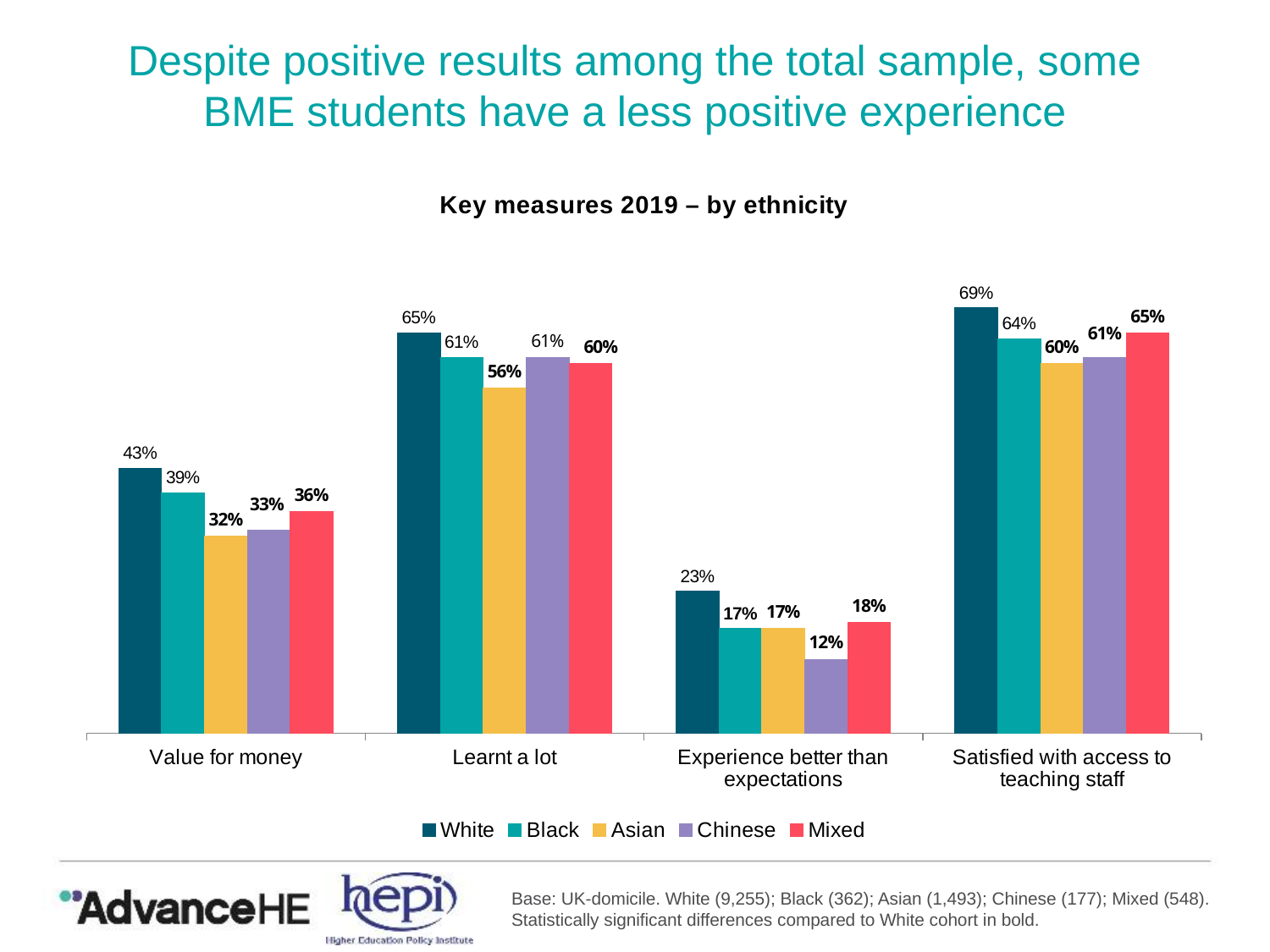
What is the value for Mixed students on 'Satisfied with access to teaching staff'? 65% Which ethnic group has the highest value for 'Satisfied with access to teaching staff'? White Which is larger on 'Learnt a lot': the value for Black students or the value for Asian students? Black What is the difference between the White and Black values for 'Value for money'? 4% Which ethnic group has the lowest value for 'Value for money'? Asian What is the title of the chart? Key measures 2019 – by ethnicity What is the value for White students on 'Value for money'? 43% How many series does the legend list? 5 What is the value for Chinese students on 'Experience better than expectations'? 12% How many categories (key measures) are shown on the x axis? 4 What is the value for Asian students on 'Learnt a lot'? 56% What kind of chart is shown on the slide? Bar chart